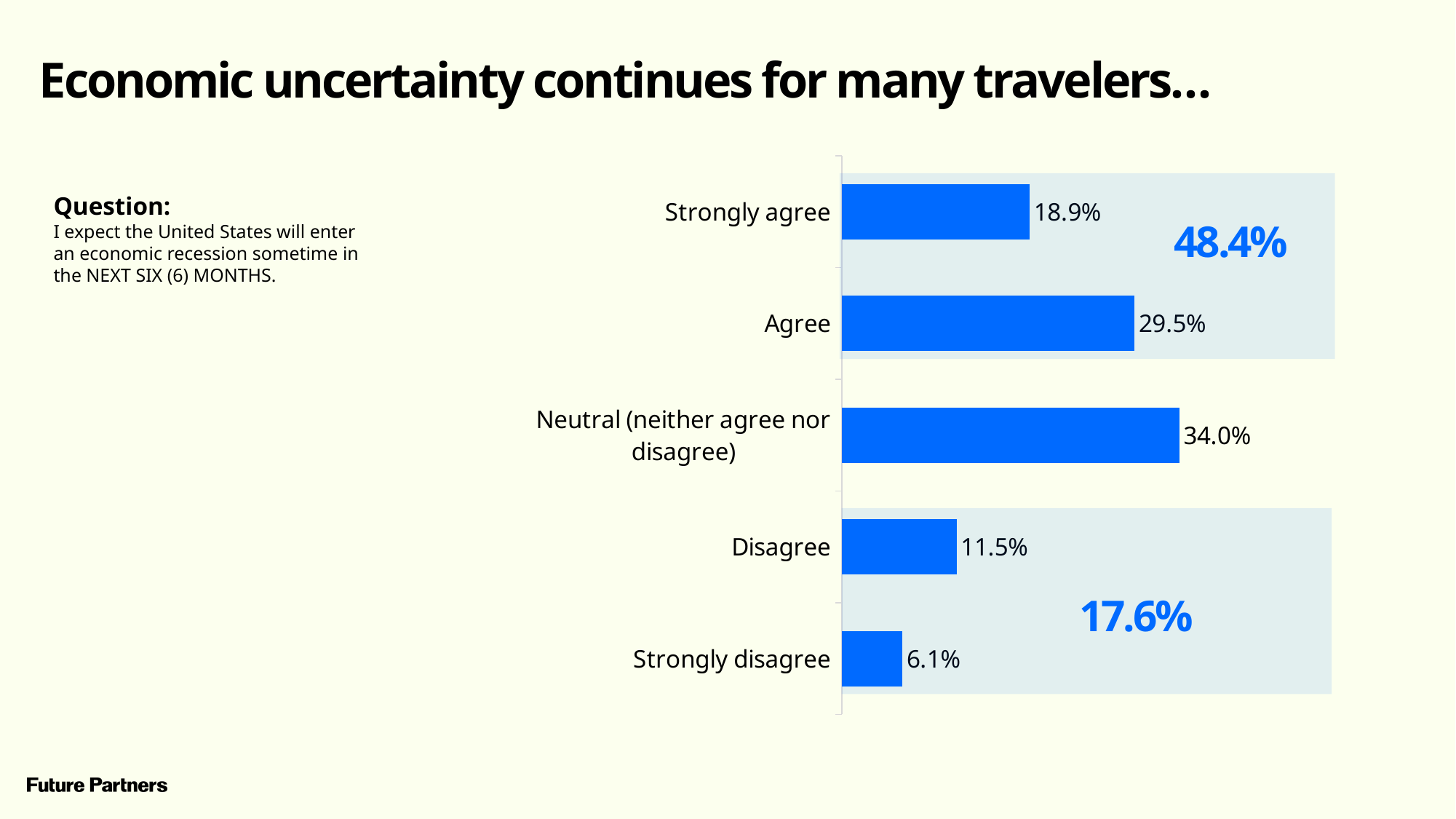
Which is larger, the value for "Disagree" or the value for "Strongly disagree"? Disagree How many response categories are shown in the chart? 5 What is the difference in percentage points between "Agree" and "Strongly agree"? 10.6 Which response category has the lowest percentage? Strongly disagree What combined percentage is shown for "Strongly agree" and "Agree" together? 48.4% What percentage of respondents answered "Agree"? 29.5% What percentage of respondents answered "Neutral (neither agree nor disagree)"? 34.0% What kind of chart is shown on the slide? Bar chart Which response category has the highest percentage? Neutral (neither agree nor disagree) What combined percentage is shown for "Disagree" and "Strongly disagree" together? 17.6% What percentage of respondents answered "Strongly agree"? 18.9% What percentage of respondents answered "Strongly disagree"? 6.1%